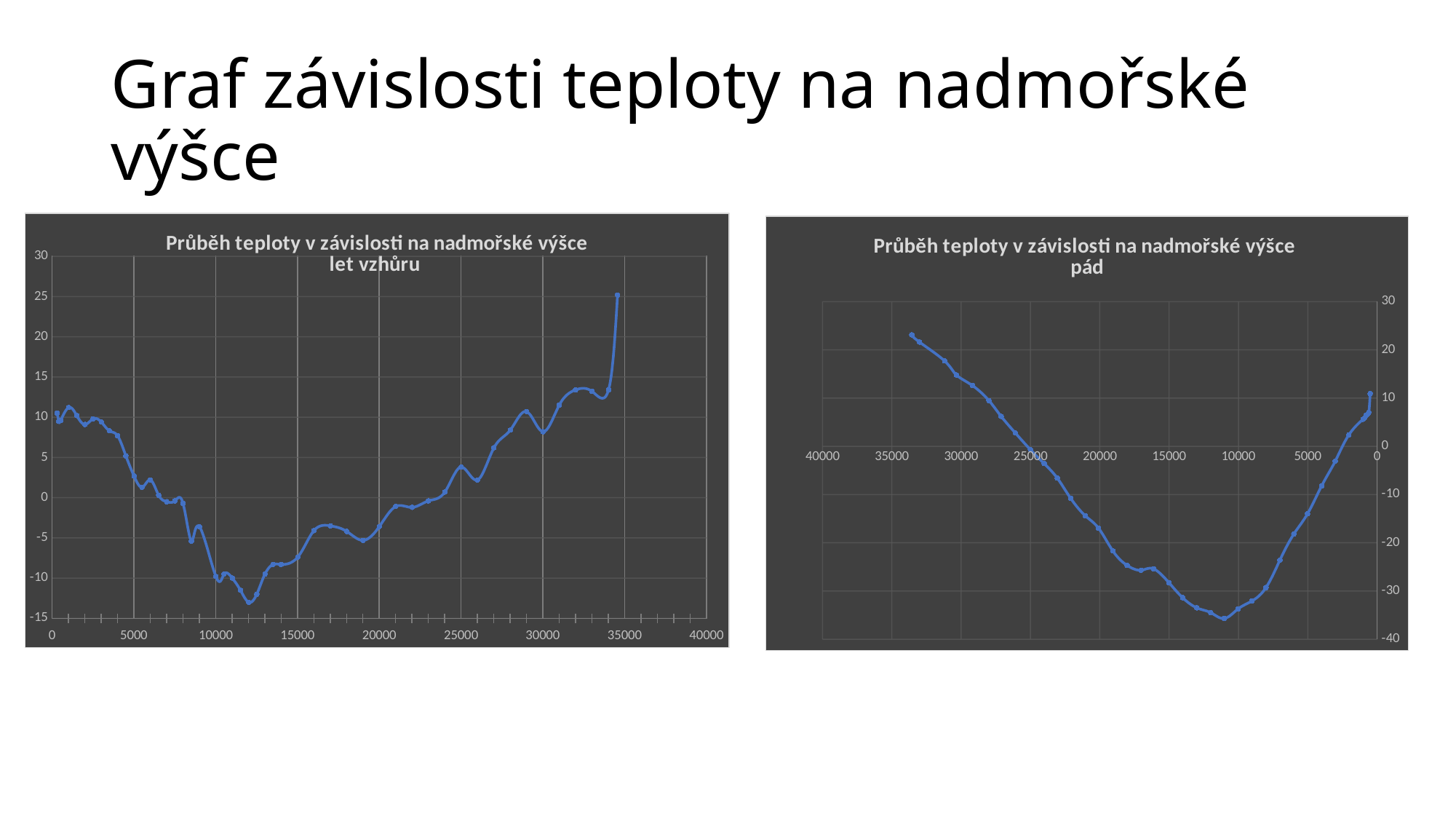
In the left chart ('let vzhůru'), is the value at x = 12000 greater or less than -10? less In the left chart ('let vzhůru'), is the value at x = 20000 greater or less than 0? less What kind of chart is the left chart titled 'Průběh teploty v závislosti na nadmořské výšce let vzhůru'? line chart In the left chart ('let vzhůru'), is the value of the last plotted point (near x = 35000) greater or less than 20? greater What is the lowest tick shown on the vertical axis of the right chart ('pád')? -40 How many charts are shown on the slide? 2 In the right chart ('pád'), do the values rise or fall as x goes from 35000 to 15000? fall In the left chart ('let vzhůru'), do the values overall rise or fall as x goes from 12000 to 35000? rise What is the title of the right chart? Průběh teploty v závislosti na nadmořské výšce pád